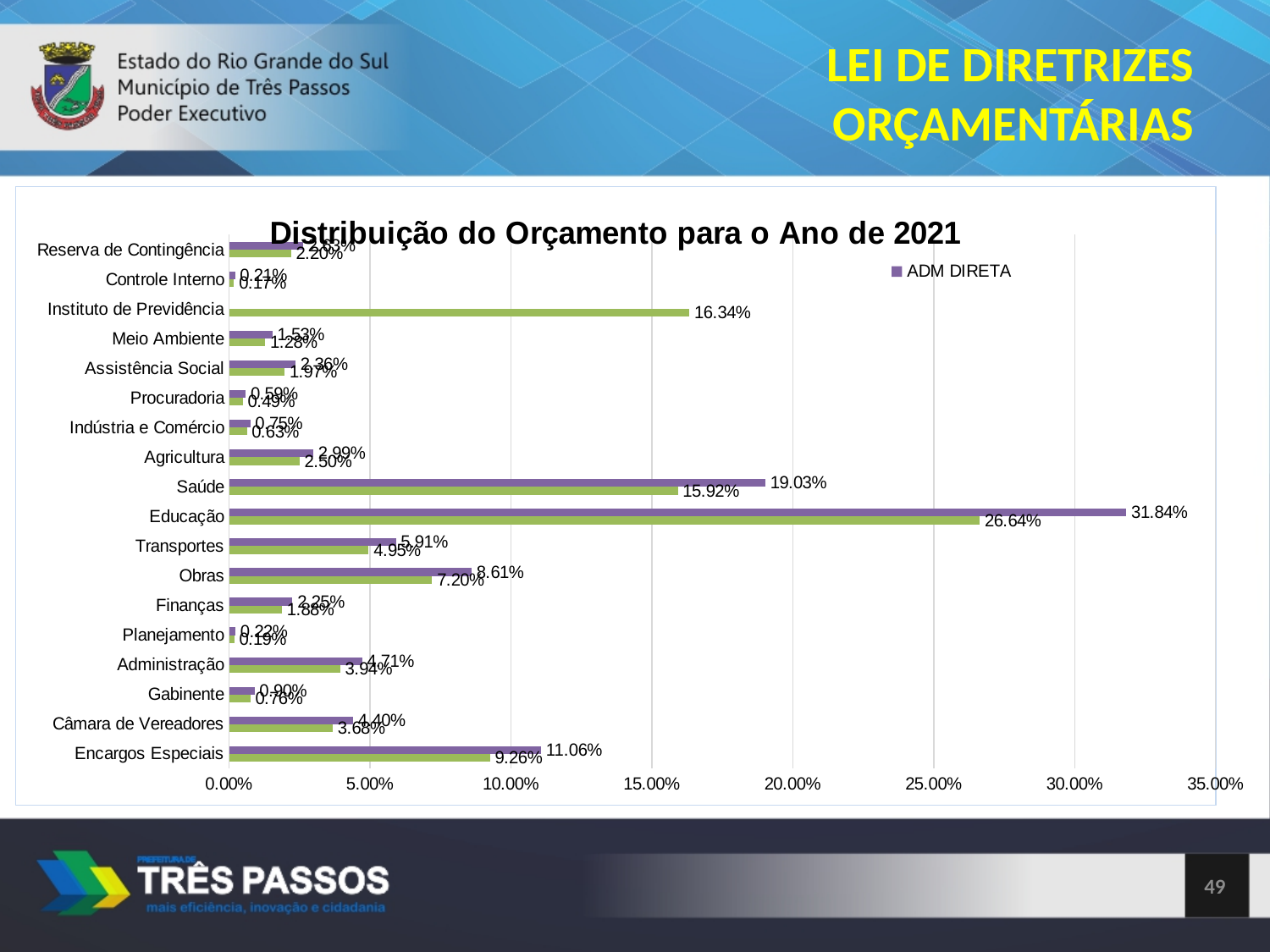
Which has the larger ADM DIRETA value, Obras or Transportes? Obras What is the difference between the ADM DIRETA values for Educação and Saúde? 12.81% What is the title of the chart? Distribuição do Orçamento para o Ano de 2021 What is the ADM DIRETA value for Saúde? 19.03% What is the difference between the two values shown for Encargos Especiais (11.06% and 9.26%)? 1.80% What kind of chart is shown on the slide? bar chart How many series does the chart's legend list? 1 What is the ADM DIRETA value for Encargos Especiais? 11.06% What is the ADM DIRETA value for Educação? 31.84% Is the value shown for Instituto de Previdência greater or less than 15.00%? greater How many categories are listed on the vertical axis of the chart? 18 Which category has the highest ADM DIRETA value? Educação